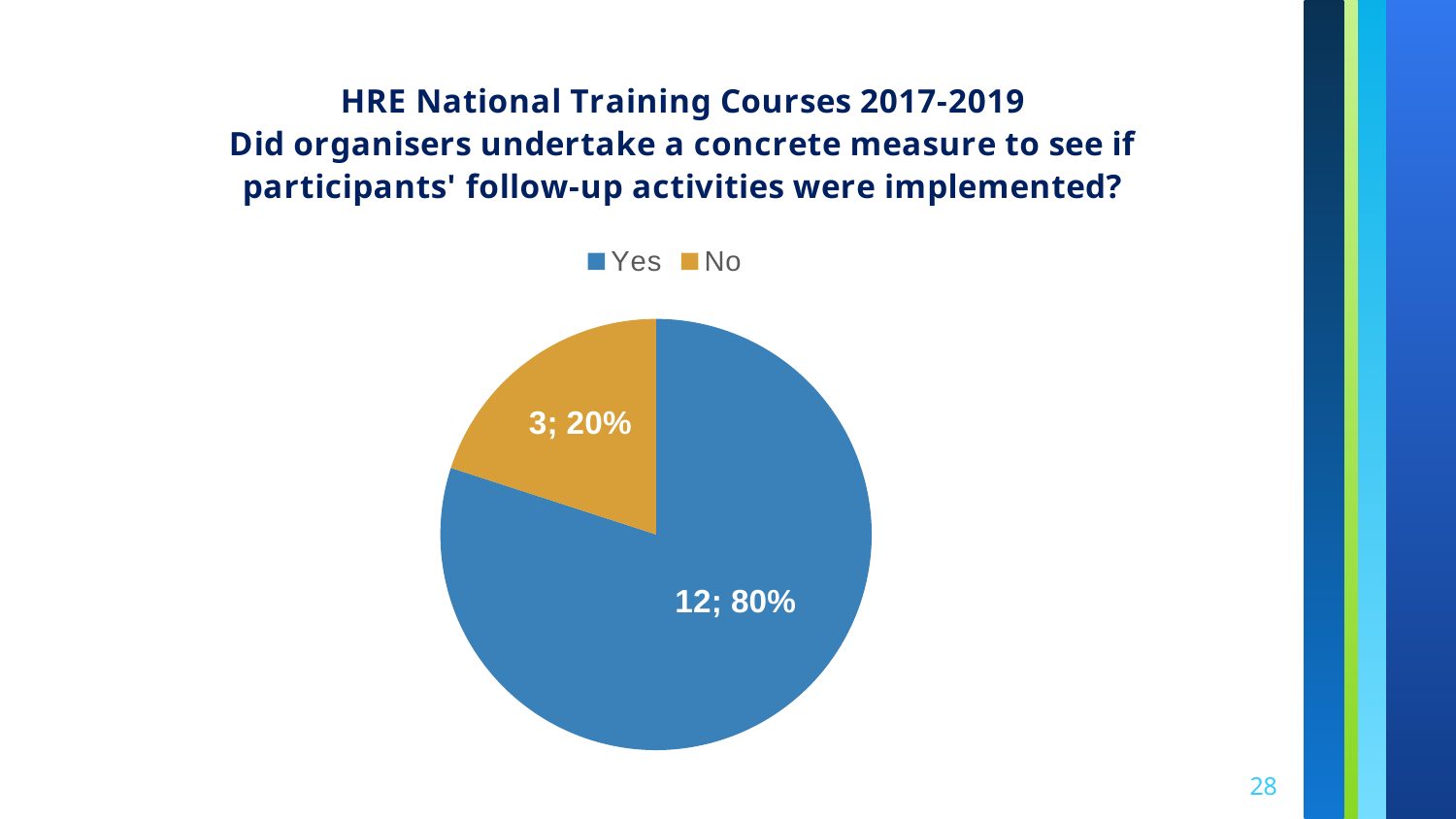
What percentage of the pie does the "No" slice represent? 20% Which response has the smallest slice of the pie? No What percentage of the pie does the "Yes" slice represent? 80% What colour is the "No" slice of the pie chart? Orange What kind of chart is shown on the slide? Pie chart How many slices does the pie chart have? 2 Which is larger, the "Yes" slice or the "No" slice? Yes How many organisers answered "No"? 3 What is the total number of responses shown in the pie chart? 15 Which response has the largest slice of the pie? Yes What is the difference between the number of "Yes" and "No" responses? 9 How many organisers answered "Yes"? 12